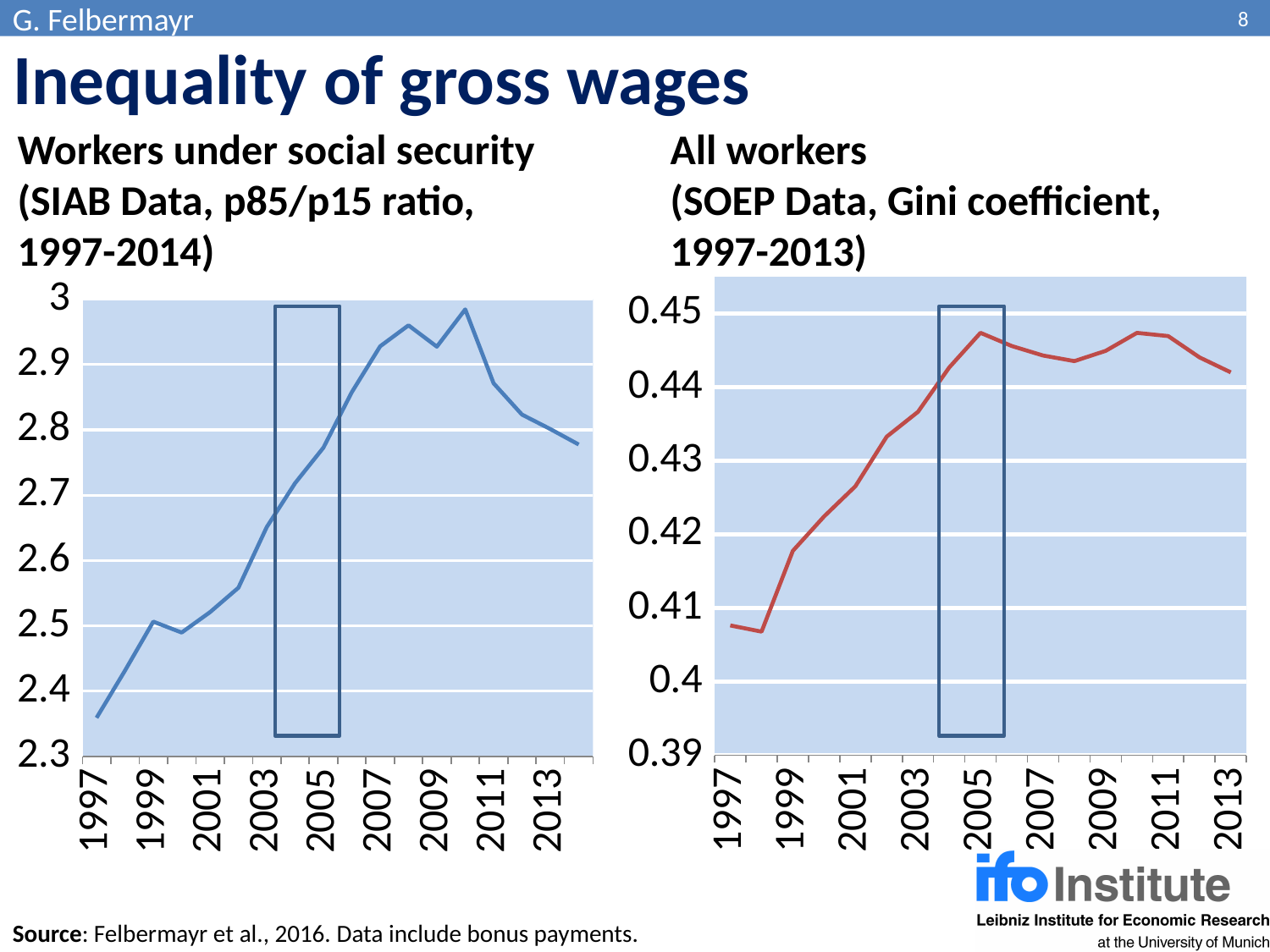
In the right chart (SOEP Data, Gini coefficient), which is larger, the value for 1997 or the value for 2013? 2013 In the right chart (SOEP Data, Gini coefficient), do the values generally rise or fall between 1997 and 2005? rise What kind of chart is the left chart (Workers under social security)? line chart In the left chart (SIAB Data, p85/p15 ratio), is the value for 1997 greater or less than 2.4? less In the left chart (SIAB Data, p85/p15 ratio), which year has the lowest value? 1997 In the right chart (SOEP Data, Gini coefficient), is the value for 1999 greater or less than 0.42? less What is the title of the slide containing the two charts? Inequality of gross wages In the right chart (SOEP Data, Gini coefficient), is the value for 2013 greater or less than 0.44? greater What kind of chart is the right chart (All workers)? line chart In the left chart (SIAB Data, p85/p15 ratio), which year has the highest value? 2010